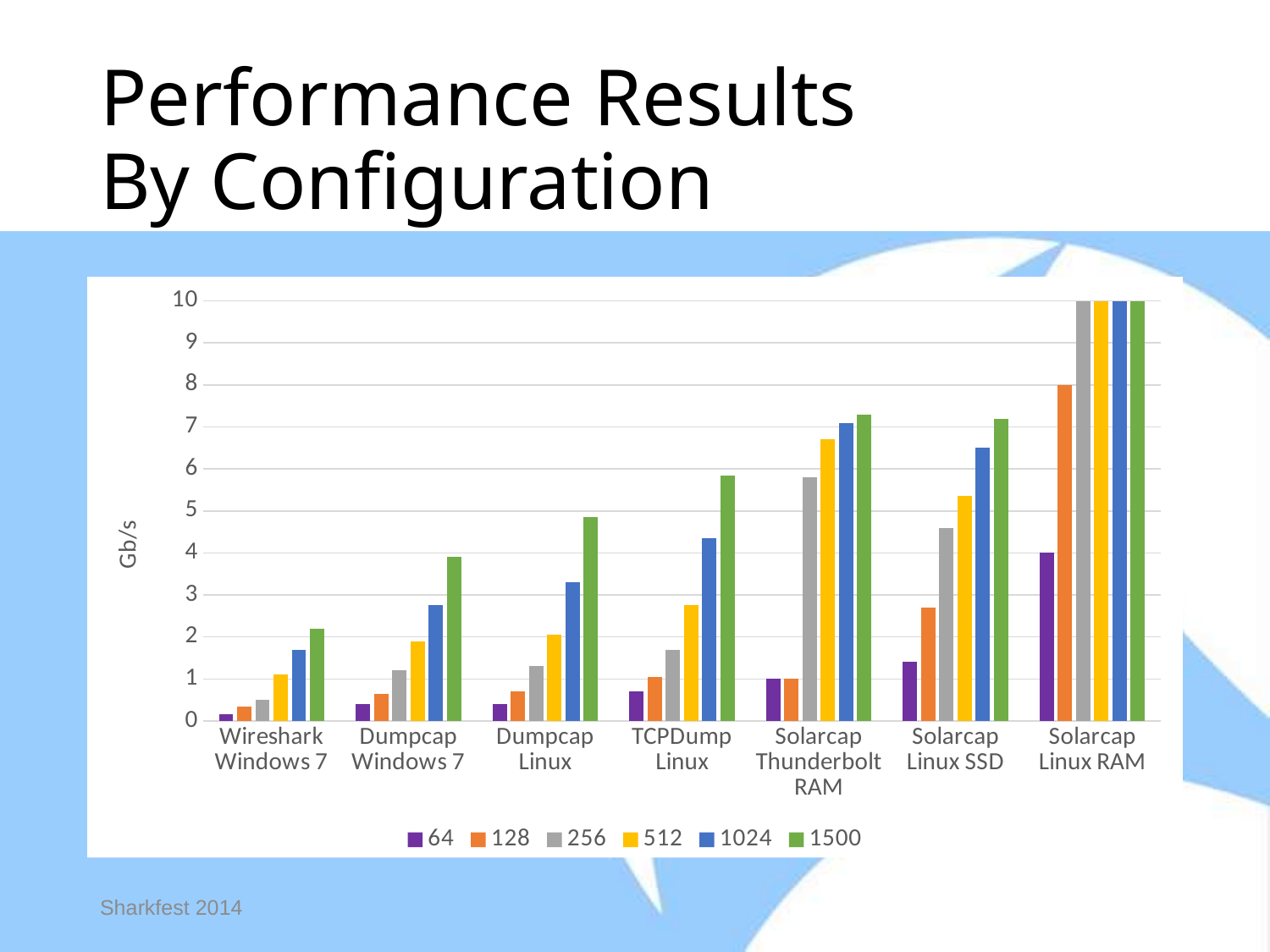
Is the value for the 1500 series for Wireshark Windows 7 greater or less than 3? less What is the value for the 128 series for Solarcap Linux RAM? 8 What is the label on the y axis? Gb/s For Solarcap Linux RAM, what is the difference between the 1500 series value and the 64 series value? 6 For the 1024 series, which is larger: Solarcap Thunderbolt RAM or Solarcap Linux SSD? Solarcap Thunderbolt RAM How many configurations are shown along the x axis? 7 What is the value for the 1500 series for Solarcap Linux RAM? 10 What kind of chart is shown on the slide? bar chart How many series does the legend list? 6 Which configuration has the highest value for the 1500 series? Solarcap Linux RAM What is the value for the 64 series for Solarcap Linux RAM? 4 Is the value for the 1500 series for TCPDump Linux greater or less than 5? greater